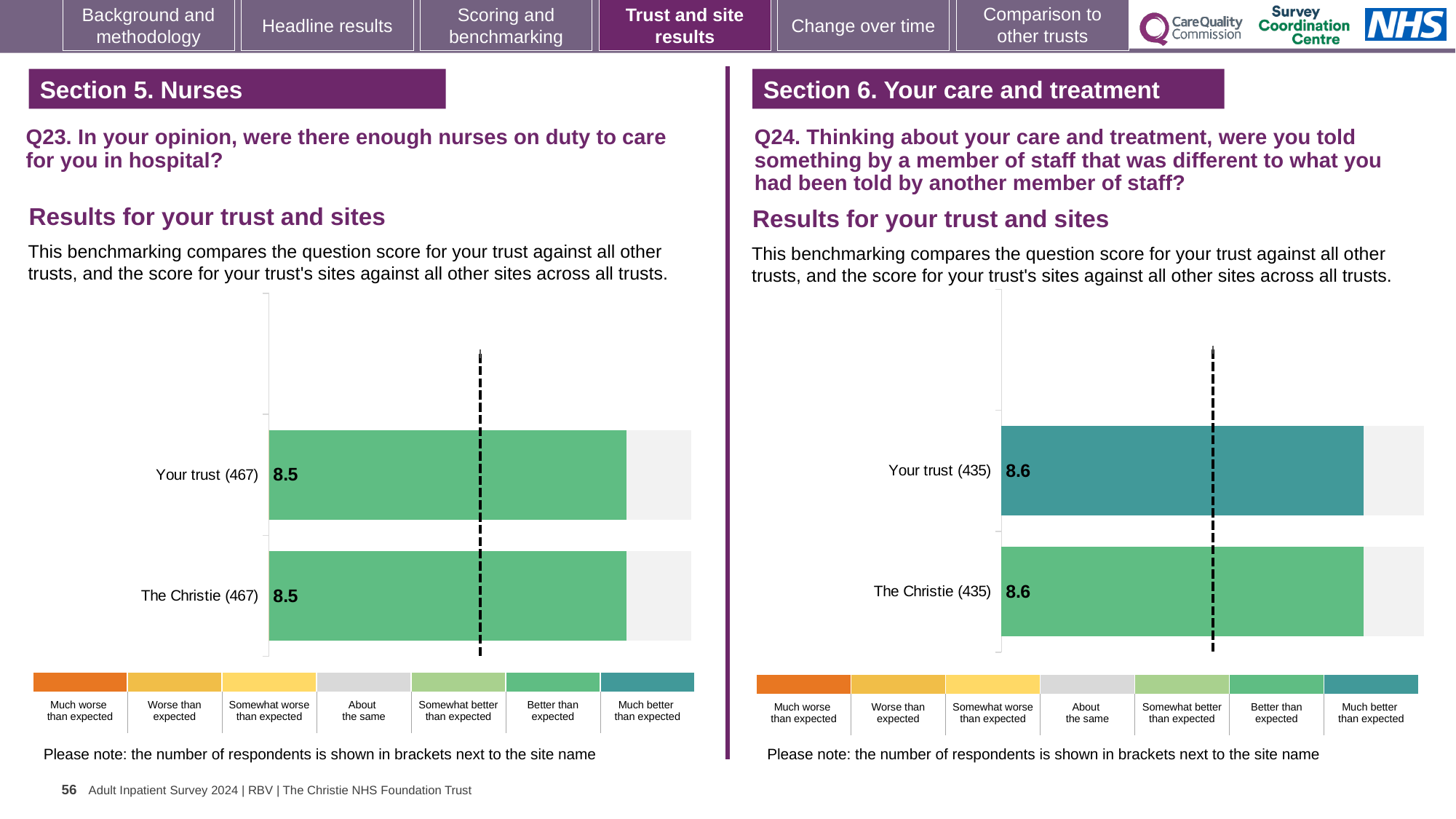
In the Q23 chart on the left, what is the score for Your trust? 8.5 In the Q23 chart on the left, how many respondents are shown in brackets next to Your trust? 467 How many bars are plotted in the Q24 chart on the right? 2 In the Q24 chart on the right, what is the score for The Christie? 8.6 Is the score for Your trust in the Q24 chart on the right larger than the score for Your trust in the Q23 chart on the left? Yes In the Q24 chart on the right, what is the difference between the score for Your trust and the score for The Christie? 0 In the Q24 chart on the right, what is the score for Your trust? 8.6 In the Q24 chart on the right, how many respondents are shown in brackets next to The Christie? 435 How many bars are plotted in the Q23 chart on the left? 2 In the Q23 chart on the left, what is the score for The Christie? 8.5 What kind of chart is used for the Q23 results on the left? Bar chart In the Q23 chart on the left, what is the difference between the score for Your trust and the score for The Christie? 0